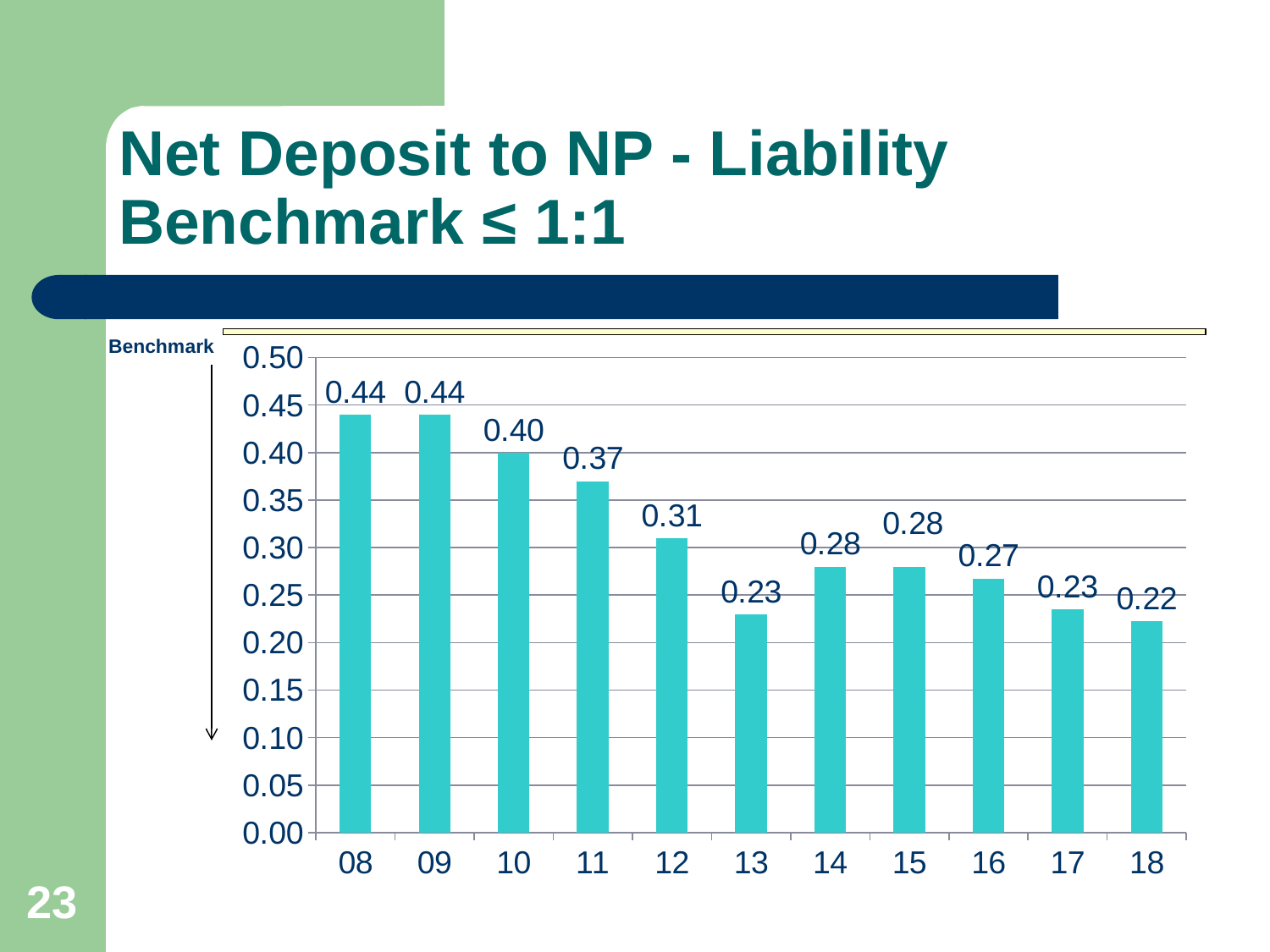
What is the value for 16? 0.27 What is the difference between the values for 10 and 13? 0.17 Do the values generally rise or fall from 08 to 18? fall What is the difference between the values for 11 and 17? 0.14 What is the value for 18? 0.22 Is the value for 15 greater or less than 0.25? greater What kind of chart is this? bar chart How many categories are shown on the x axis? 11 Which category has the lowest value? 18 What is the value for 08? 0.44 Which is larger, the value for 14 or the value for 13? 14 What is the value for 12? 0.31